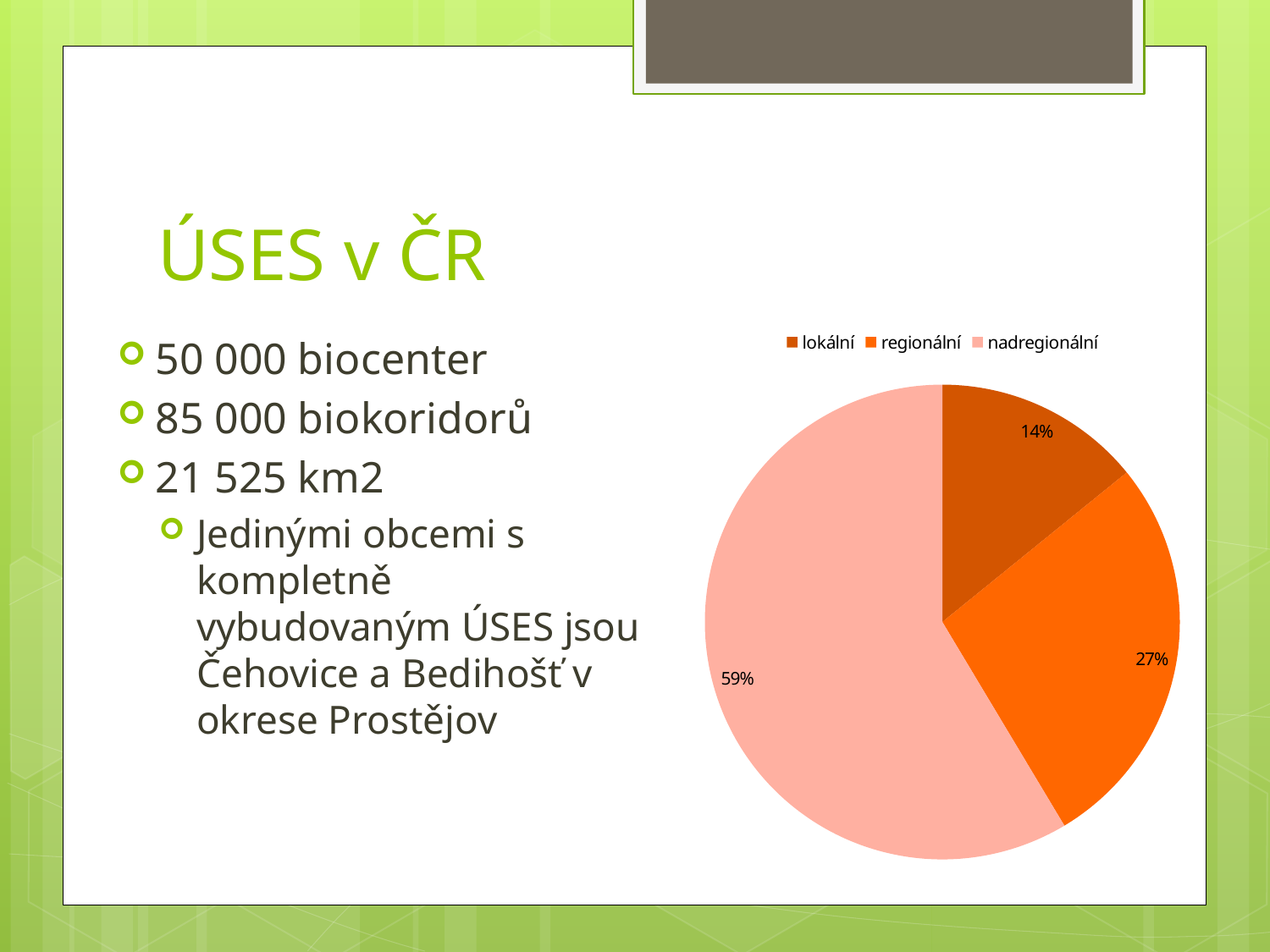
Which legend entry is shown in the lightest (pale pink) colour? nadregionální What share of the pie does the 'lokální' slice represent? 14% What kind of chart is shown on the slide? pie chart Which category has the largest slice of the pie? nadregionální What is the difference in percentage points between the 'regionální' and 'lokální' slices? 13 What is the difference in percentage points between the 'nadregionální' and 'regionální' slices? 32 Which slice is larger, 'regionální' or 'lokální'? regionální Which category has the smallest slice of the pie? lokální How many entries does the legend list? 3 What share of the pie does the 'regionální' slice represent? 27% How many slices does the pie chart have? 3 What share of the pie does the 'nadregionální' slice represent? 59%